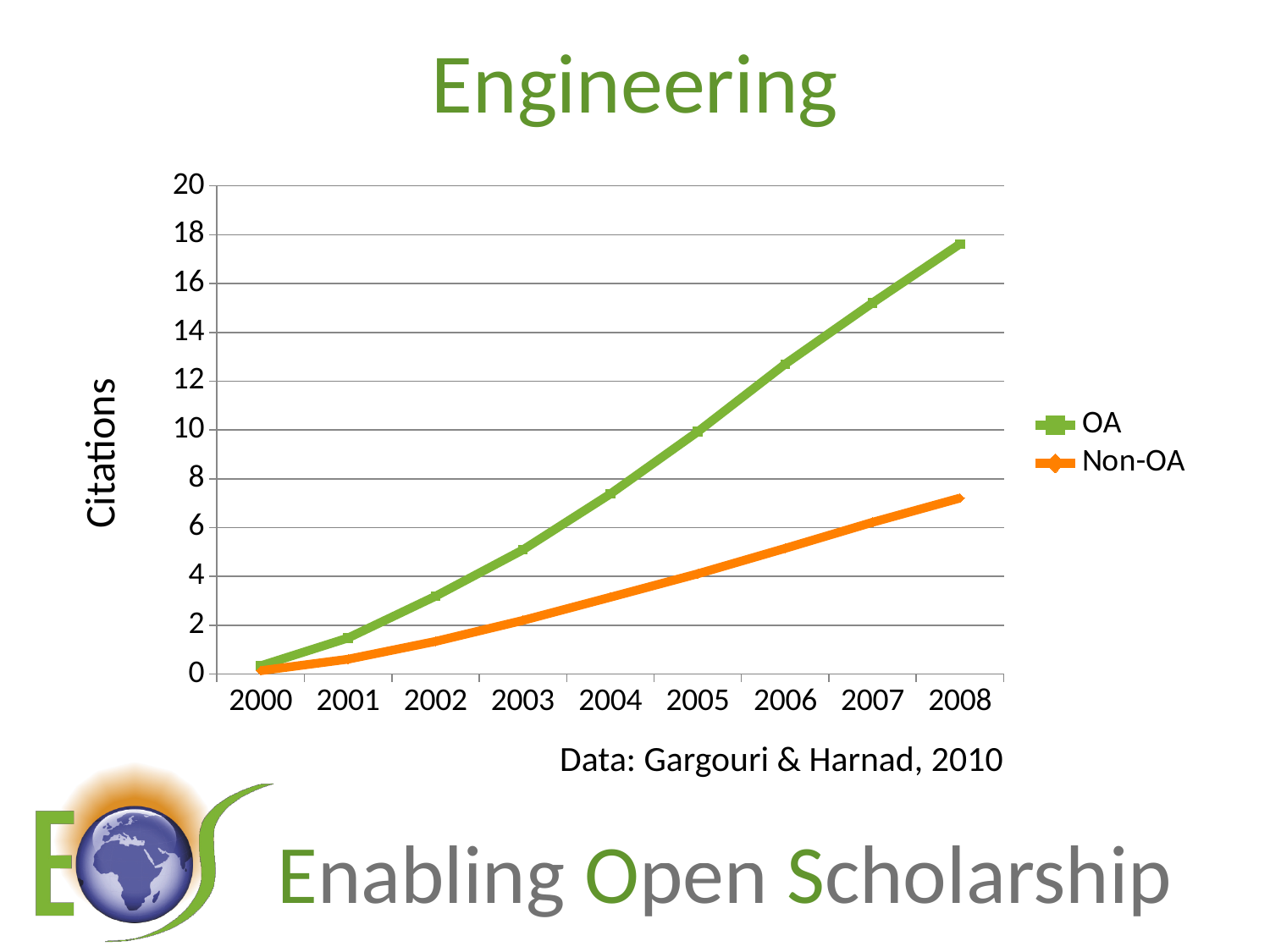
In which year is the Non-OA series at its lowest value? 2000 What is the label on the y axis of the chart? Citations In which year does the OA series reach its highest value? 2008 Is the OA value for 2004 greater or less than 8? less Is the Non-OA value for 2004 greater or less than 4? less How many series does the legend list? 2 Which series has the higher value in 2008, OA or Non-OA? OA Do the OA citations rise or fall from 2000 to 2008? rise How many years are plotted along the x axis? 9 What type of chart is shown on the slide? line chart Is the Non-OA value for 2008 greater or less than 8? less